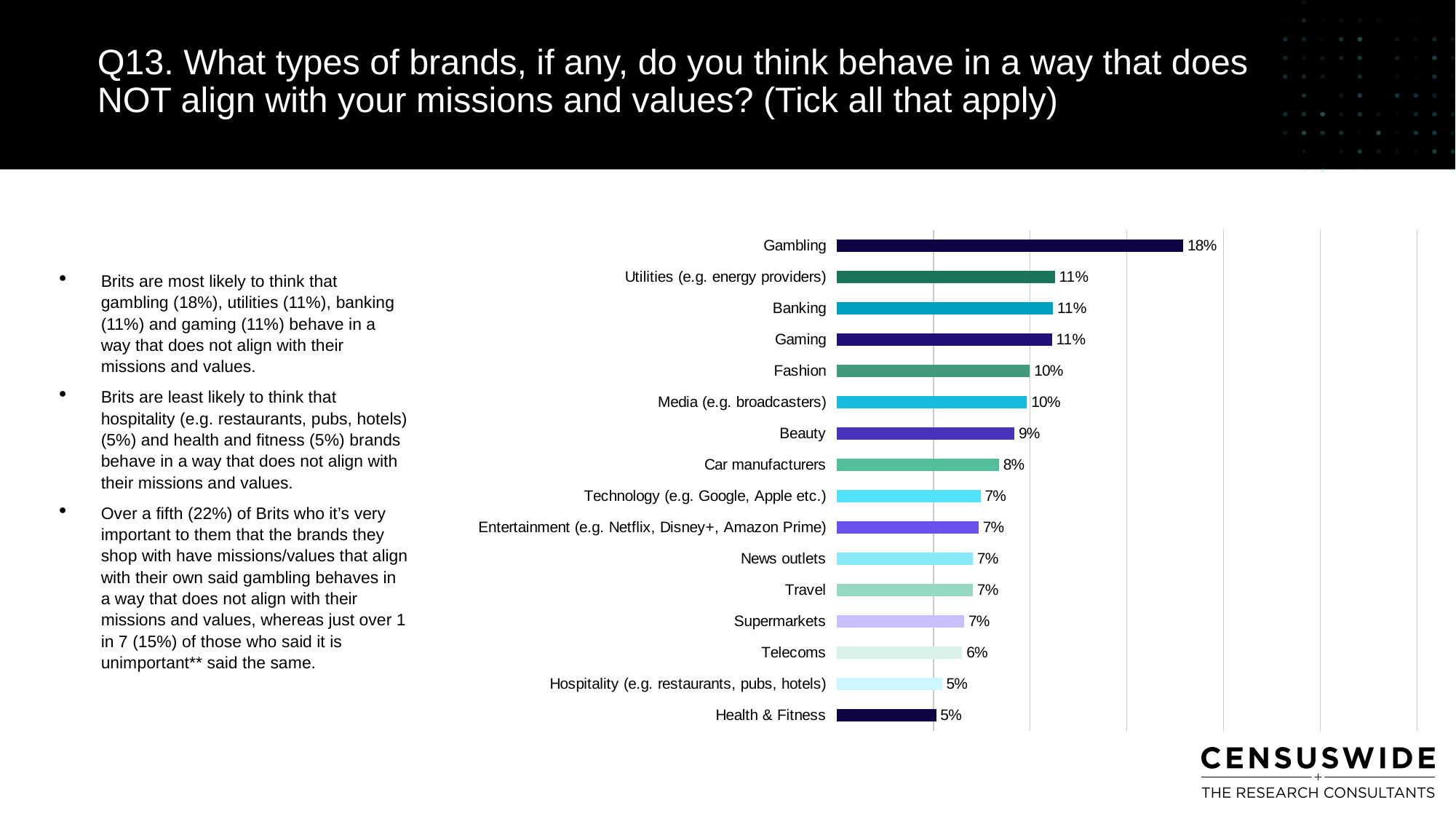
How many brand types are listed in the chart? 16 What kind of chart is shown on the slide? Bar chart What is the difference between the values for Fashion and Health & Fitness? 5 percentage points Which has a higher value, Beauty or Car manufacturers? Beauty What is the difference in percentage points between Gambling and Banking? 7 percentage points Which brand type has the highest percentage in the chart? Gambling What is the value for Media (e.g. broadcasters)? 10% What percentage of respondents selected Gambling? 18% Which has a higher value, Telecoms or Supermarkets? Supermarkets What percentage is shown for Telecoms? 6% What is the value shown for Car manufacturers? 8% Are the bars ordered from highest to lowest value going down the chart? Yes